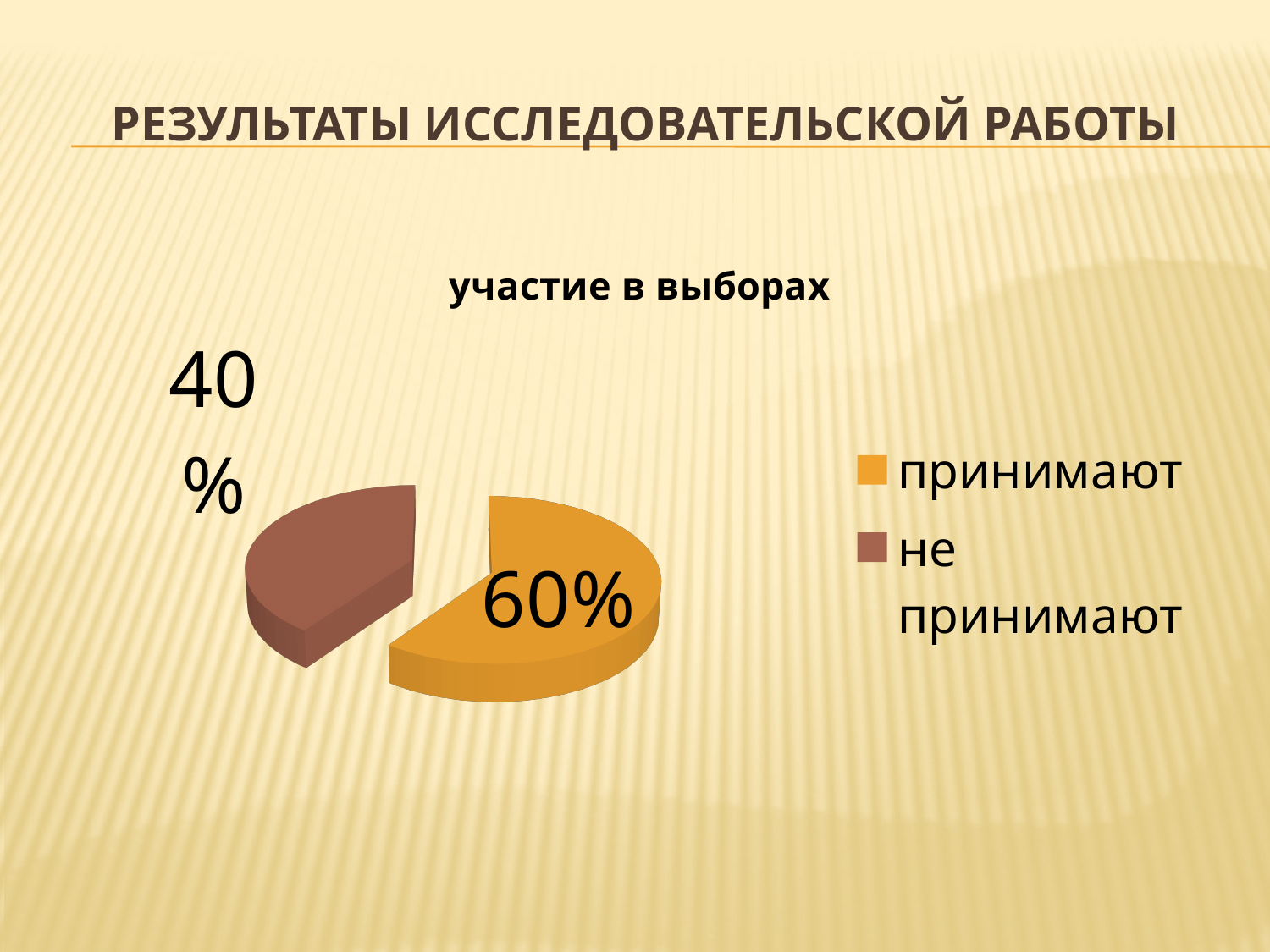
How many entries does the legend list? 2 How many slices does the pie chart have? 2 What percentage of the pie is labelled "принимают"? 60% What colour is the "не принимают" slice? brown Which slice of the pie is the largest? принимают What is the difference in percentage points between the "принимают" and "не принимают" slices? 20 What kind of chart is shown on the slide? pie chart Which is larger: the "принимают" slice or the "не принимают" slice? принимают What share of the pie does the "принимают" slice represent? 60% Which slice of the pie is the smallest? не принимают What is the title of the chart? участие в выборах What percentage of the pie is labelled "не принимают"? 40%